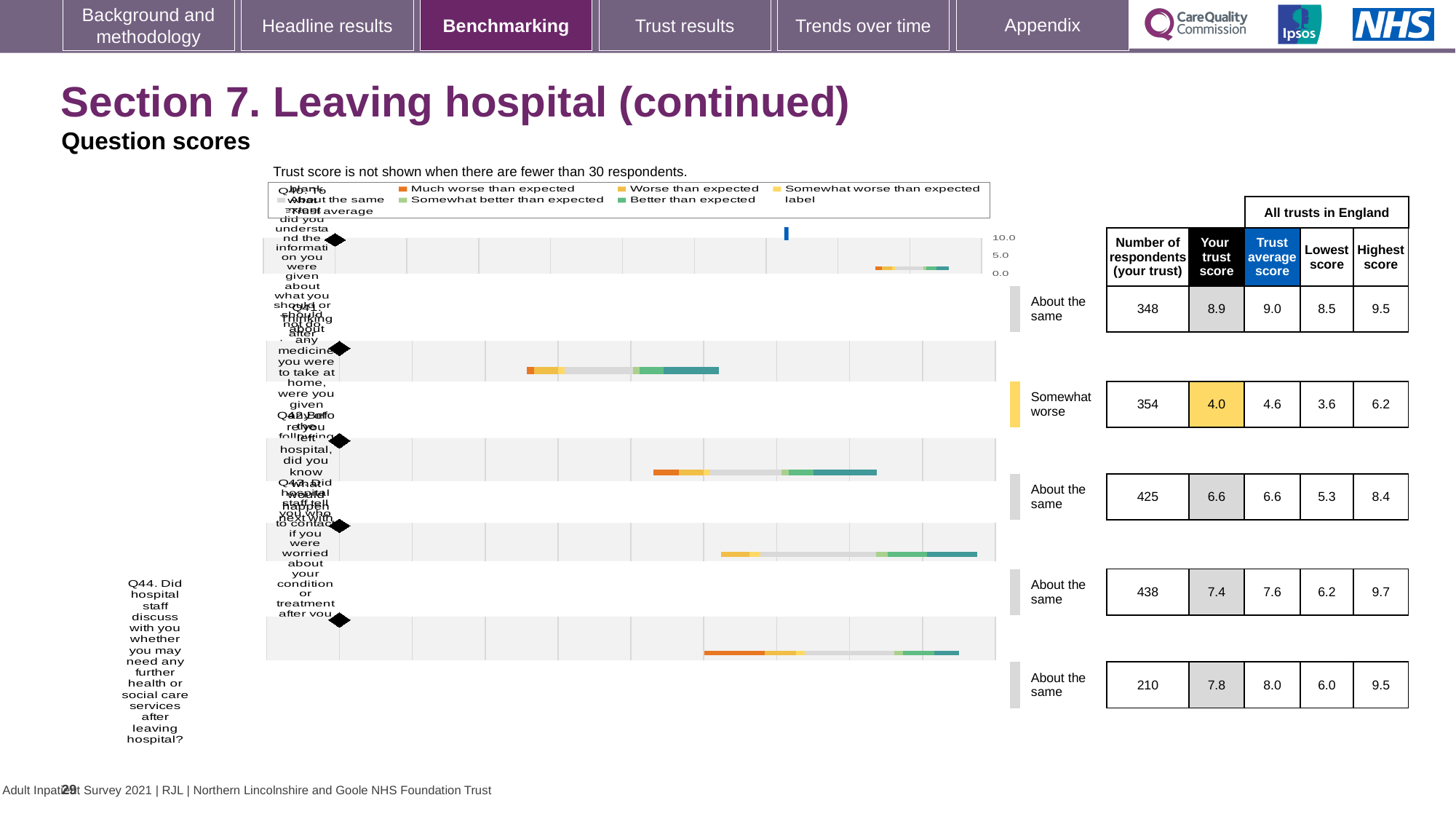
Which row of the table has the lowest 'Your trust score'? The second row (4.0) What is the benchmark category shown for the second row of the table? Somewhat worse What kind of chart is used to show the question scores on this slide? bar chart What is the highest score across all trusts in England for Q44? 9.5 What is the trust average score for Q44? 8.0 How many questions (rows) are shown in the benchmarking table on this slide? 5 What is the trust's score for Q44 in the table? 7.8 What is the difference between the highest score (9.5) and the lowest score (6.0) for Q44? 3.5 What is the number of respondents in the first row of the table? 348 Which row of the table has the highest number of respondents? The fourth row (438) For Q44, which is larger: the trust's own score or the trust average score? Trust average score What is the number of respondents for Q44 (whether you may need further health or social care services after leaving hospital)? 210